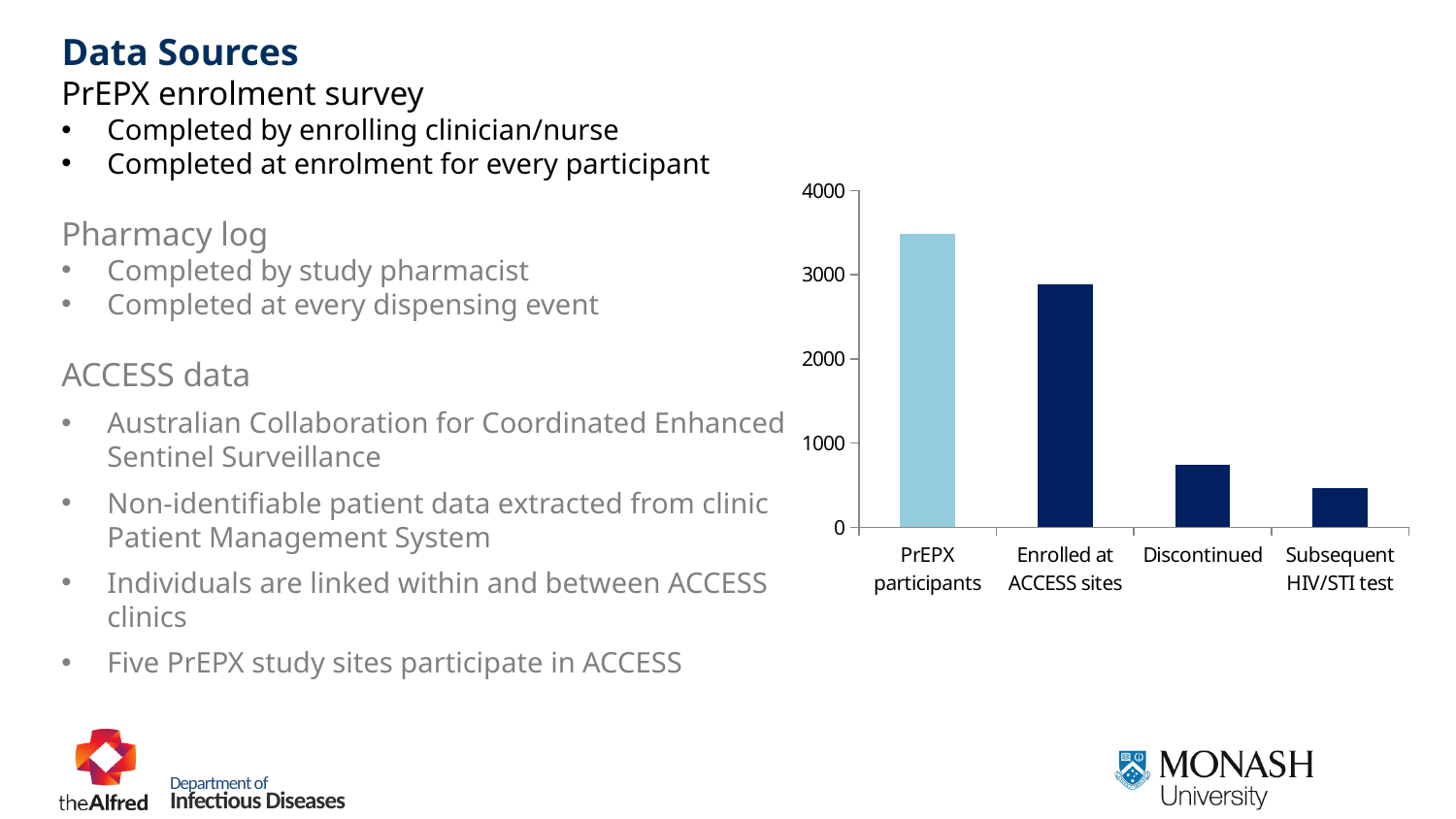
Which category has the lowest bar in the chart? Subsequent HIV/STI test Is the value for Subsequent HIV/STI test greater or less than 1000? less Which category has the highest bar in the chart? PrEPX participants How many categories are shown on the x axis of the chart? 4 Is the value for PrEPX participants greater or less than 3000? greater Which is larger, the value for Discontinued or the value for Subsequent HIV/STI test? Discontinued Do the bar values rise or fall from left to right along the x axis? fall Which is larger, the value for Enrolled at ACCESS sites or the value for Discontinued? Enrolled at ACCESS sites Is the value for Discontinued greater or less than 1000? less What kind of chart is shown on the slide? bar chart Which bar in the chart is coloured light blue rather than dark blue? PrEPX participants